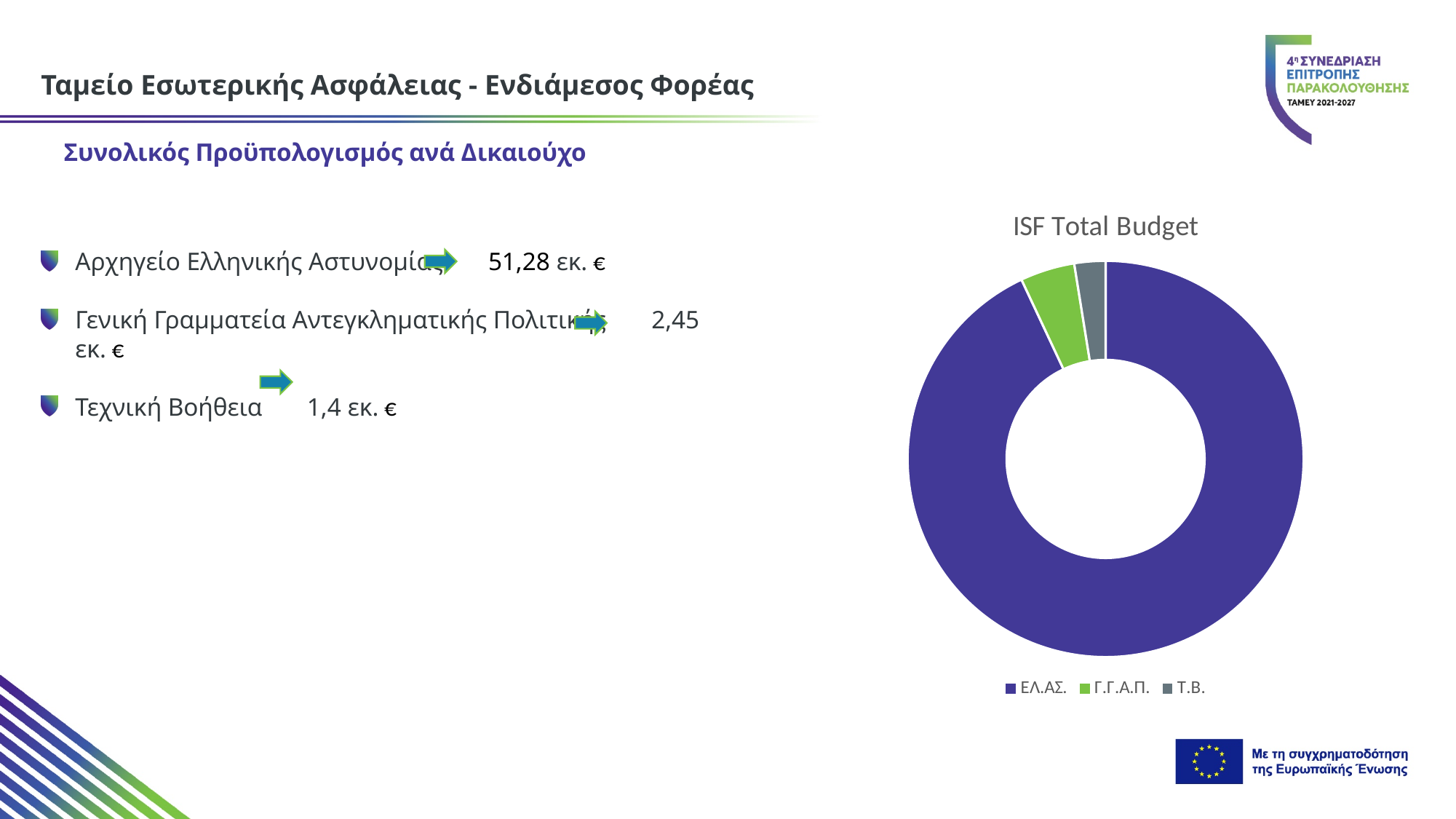
In the ISF Total Budget chart, which slice is larger: ΕΛ.ΑΣ. or Γ.Γ.Α.Π.? ΕΛ.ΑΣ. Does the ΕΛ.ΑΣ. slice account for more or less than half of the ISF Total Budget doughnut? more Which category has the largest slice in the ISF Total Budget chart? ΕΛ.ΑΣ. Which category has the smallest slice in the ISF Total Budget chart? Τ.Β. In the ISF Total Budget chart, which slice is larger: Γ.Γ.Α.Π. or Τ.Β.? Γ.Γ.Α.Π. Which legend entry of the ISF Total Budget chart is shown in green? Γ.Γ.Α.Π. How many slices does the ISF Total Budget doughnut chart have? 3 What is the title of the doughnut chart on the slide? ISF Total Budget What kind of chart is shown under the title "ISF Total Budget"? doughnut chart How many entries does the legend of the ISF Total Budget chart list? 3